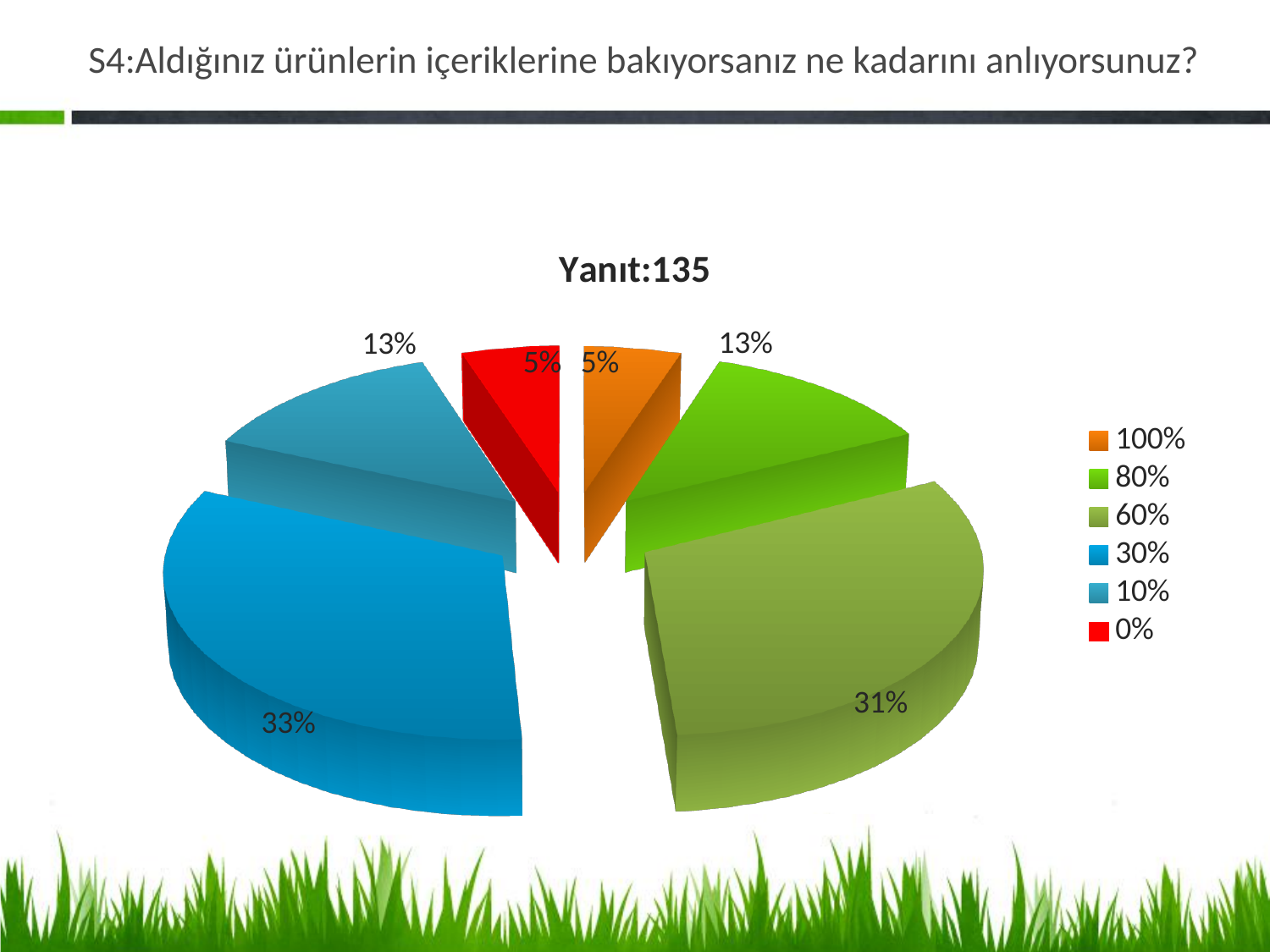
What is the value shown for the "0%" category? 5% How many entries does the legend list? 6 What share of the pie does the "60%" category take? 31% Which category has the largest slice of the pie? 30% How many slices does the pie chart have? 6 What is the title of the chart? Yanıt:135 What share of the pie does the "30%" category take? 33% What colour is the slice for the "0%" category? red What kind of chart is shown on the slide? pie chart What is the value shown for the "80%" category? 13% Which is larger, the slice for the "10%" category or the slice for the "100%" category? 10% What is the difference between the slices for the "30%" and "60%" categories? 2%